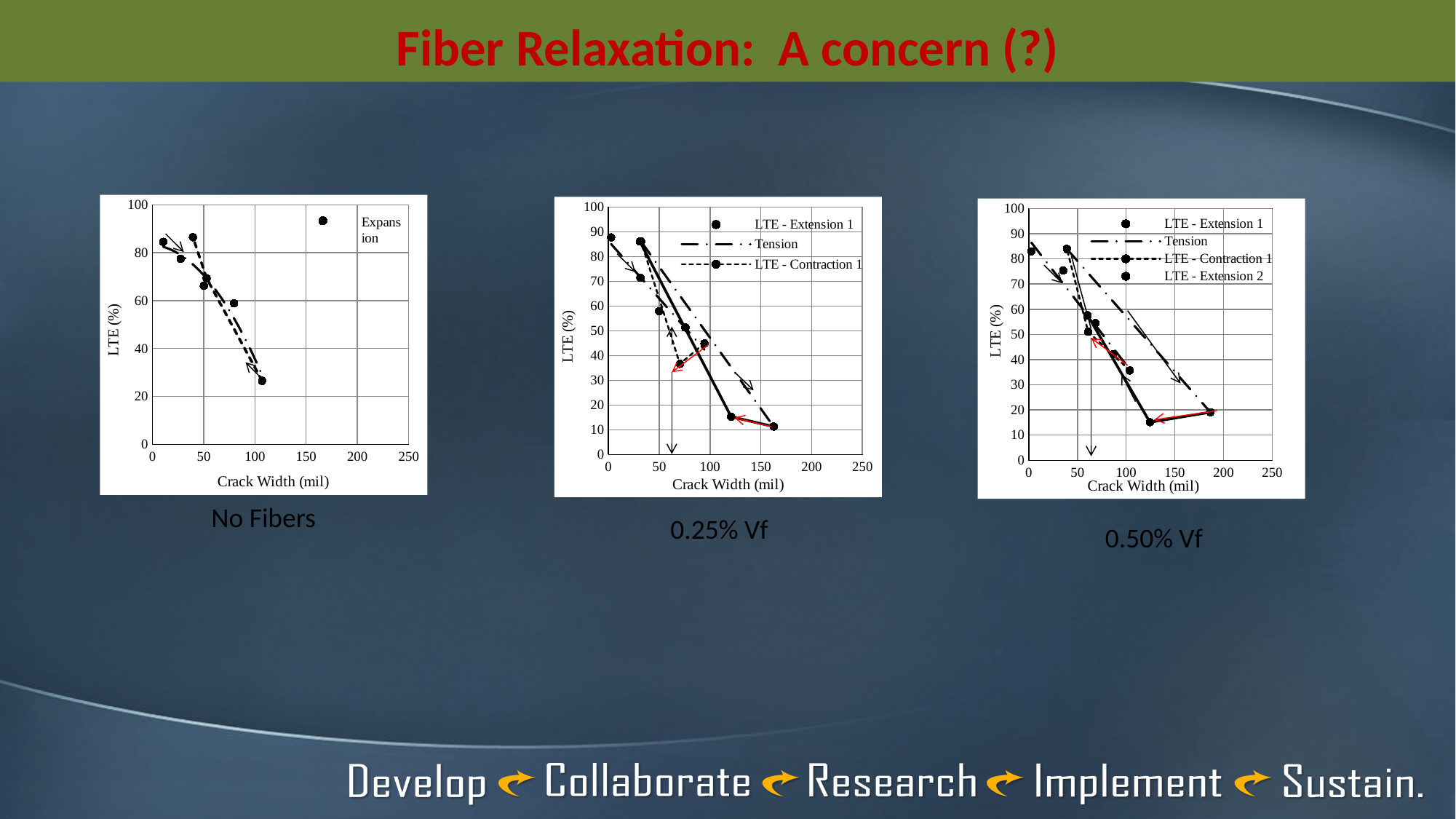
In the 'No Fibers' chart, is the LTE value of the point at the largest crack width greater or less than 40? less In the '0.50% Vf' chart, does LTE (%) rise or fall as Crack Width increases? Fall How many series does the legend of the '0.50% Vf' chart list? 4 In the '0.25% Vf' chart, is the LTE value of the point at the largest crack width greater or less than 20? less In the '0.50% Vf' chart, is the LTE value of the point at the smallest crack width greater or less than 70? greater How many series does the legend of the 'No Fibers' chart list? 1 What is the x-axis title of the '0.25% Vf' chart? Crack Width (mil) How many series does the legend of the '0.25% Vf' chart list? 3 In the 'No Fibers' chart, does LTE (%) rise or fall as Crack Width increases? Fall What kind of chart is the 'No Fibers' chart? Scatter chart with lines In the '0.50% Vf' chart, which legend entry is listed last? LTE - Extension 2